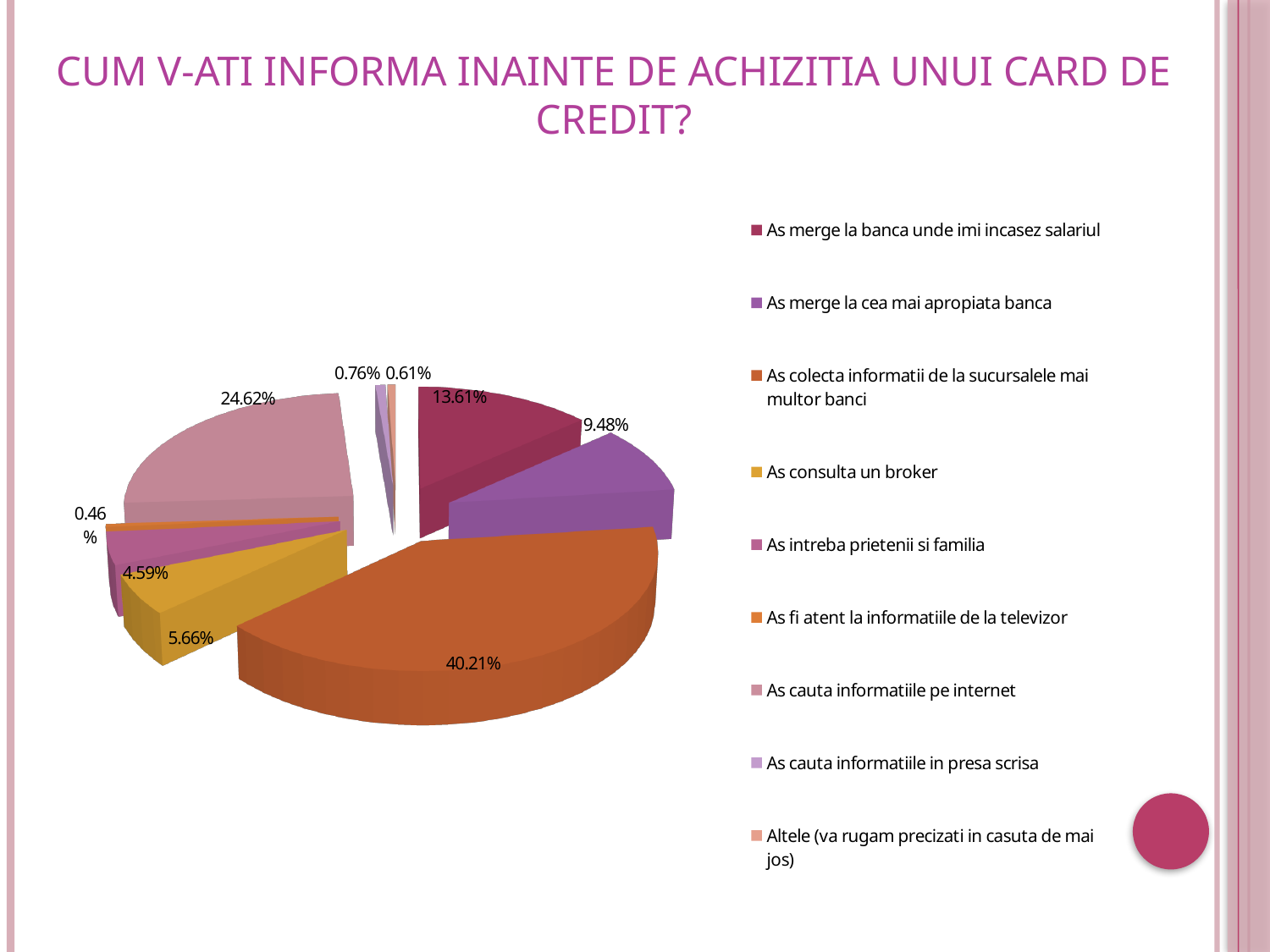
Which is larger: the share for 'As merge la cea mai apropiata banca' or for 'As intreba prietenii si familia'? As merge la cea mai apropiata banca What percentage is shown for 'As colecta informatii de la sucursalele mai multor banci'? 40.21% Which category has the smallest share of the pie? As fi atent la informatiile de la televizor What percentage is shown for 'As consulta un broker'? 5.66% What percentage is shown for 'As cauta informatiile pe internet'? 24.62% What is the title of the slide? CUM V-ATI INFORMA INAINTE DE ACHIZITIA UNUI CARD DE CREDIT? What is the difference between the shares for 'As cauta informatiile pe internet' and 'As merge la banca unde imi incasez salariul'? 11.01% What kind of chart is shown on the slide? pie chart What percentage is shown for 'As fi atent la informatiile de la televizor'? 0.46% How many categories does the legend list? 9 Which category has the largest share of the pie? As colecta informatii de la sucursalele mai multor banci What percentage is shown for 'As merge la banca unde imi incasez salariul'? 13.61%